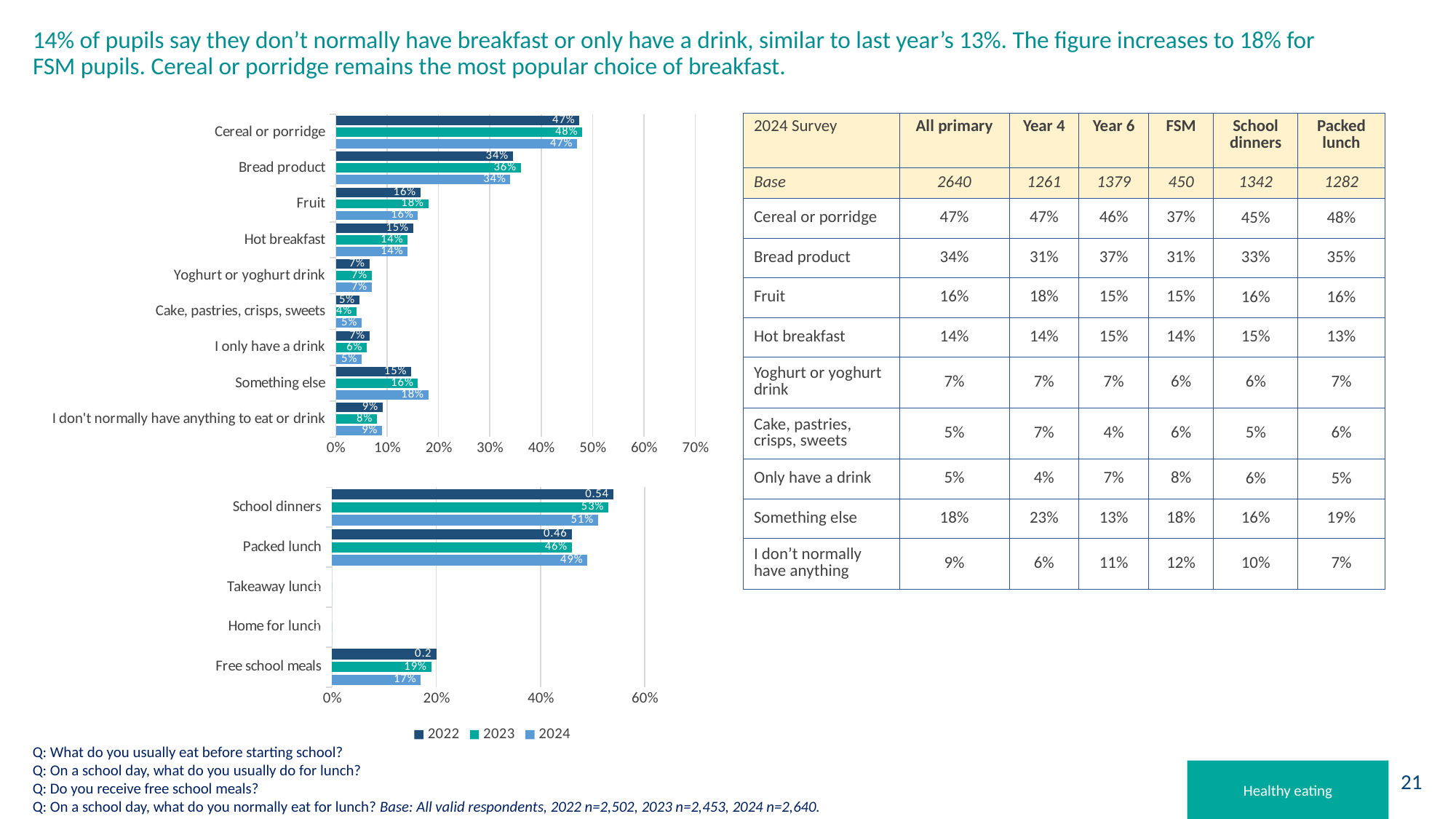
How many categories are shown in the top chart? 9 In the top chart, what is the 2023 value for Cereal or porridge? 48% In the top chart, which is larger: the 2022 value for Hot breakfast or the 2022 value for Yoghurt or yoghurt drink? Hot breakfast In the bottom chart, which category has the highest 2023 value? School dinners In the bottom chart, what is the 2023 value for Free school meals? 19% In the top chart, what is the difference between the 2023 values for Bread product and Fruit? 18% What kind of chart is the bottom chart? Bar chart Which three years are listed in the legend? 2022, 2023, 2024 How many series does the legend list? 3 In the top chart, what is the 2024 value for Something else? 18% In the bottom chart, what is the 2024 value for Packed lunch? 49% In the top chart, which category has the highest 2024 value? Cereal or porridge